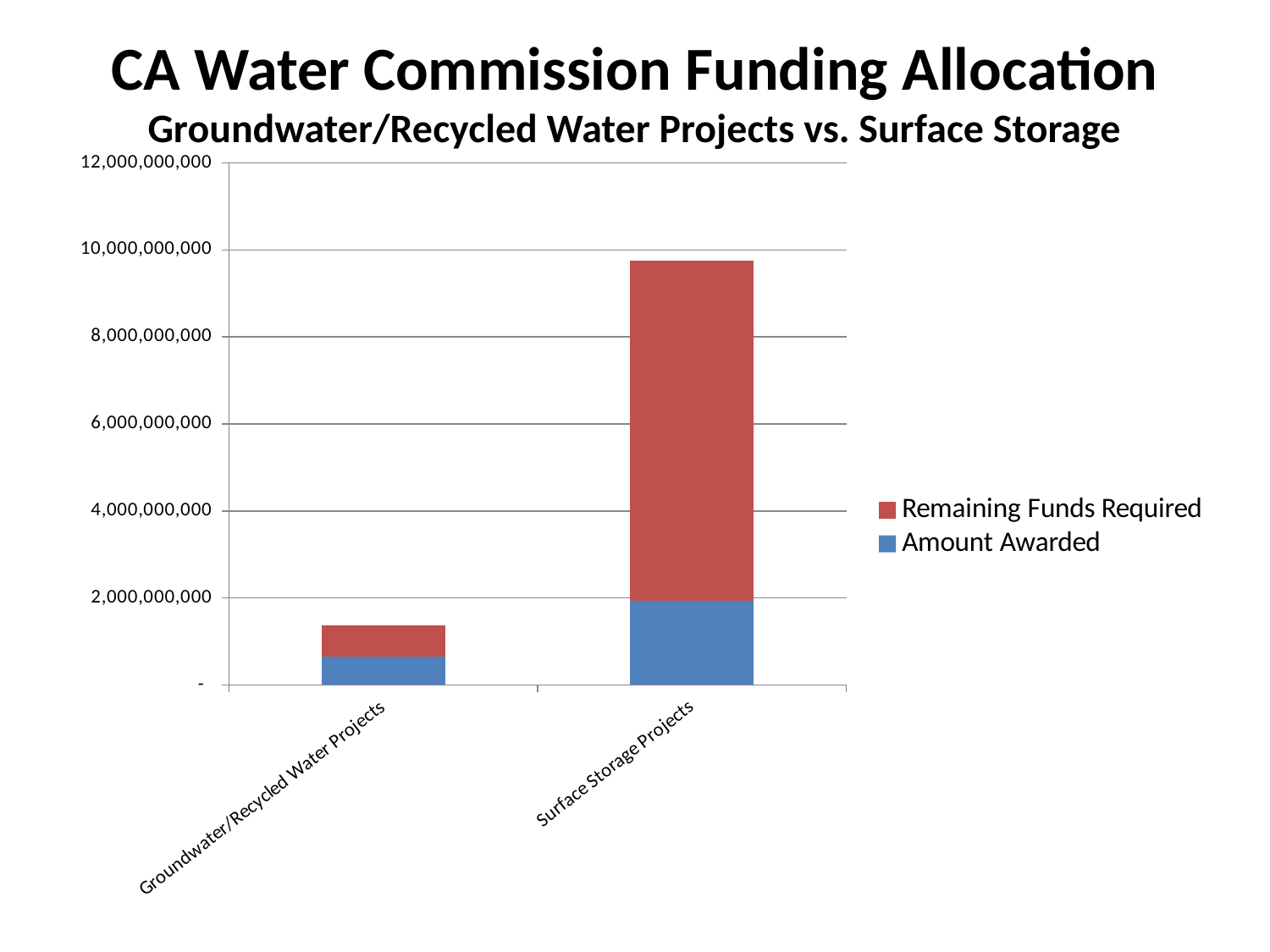
What are the two series listed in the legend? Remaining Funds Required and Amount Awarded Is the total bar for Surface Storage Projects greater or less than 10,000,000,000? less Which category has the taller total bar? Surface Storage Projects Which colour represents Amount Awarded? Blue Is the total bar for Surface Storage Projects greater or less than 8,000,000,000? greater Which category has the shorter total bar? Groundwater/Recycled Water Projects How many series does the legend list? 2 Which category has the larger Remaining Funds Required segment, Groundwater/Recycled Water Projects or Surface Storage Projects? Surface Storage Projects Is the Amount Awarded for Groundwater/Recycled Water Projects greater or less than 2,000,000,000? less How many project categories are shown on the x axis? 2 What kind of chart is shown on the slide? Stacked bar chart